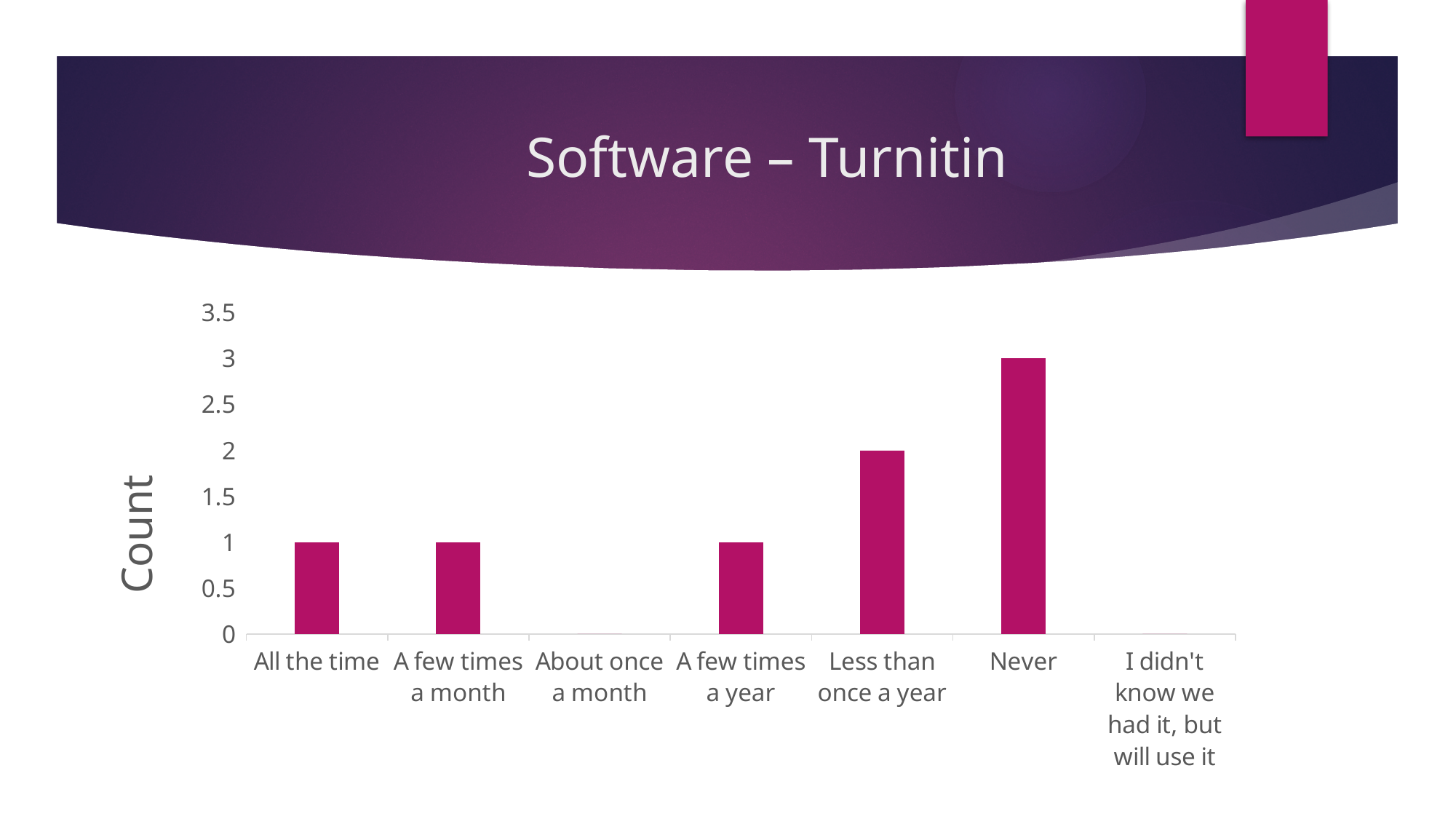
Which category has the highest count? Never Which has a larger count, "Less than once a year" or "A few times a year"? Less than once a year What is the count for "Less than once a year"? 2 What is the count for "Never"? 3 What is the count for "All the time"? 1 Is the count for "Never" greater or less than 2.5? greater How many categories are shown on the x axis? 7 What is the label on the vertical axis? Count What is the difference between the counts for "Never" and "Less than once a year"? 1 What is the title of the slide containing the chart? Software – Turnitin What is the count for "About once a month"? 0 What type of chart is shown on the slide? bar chart